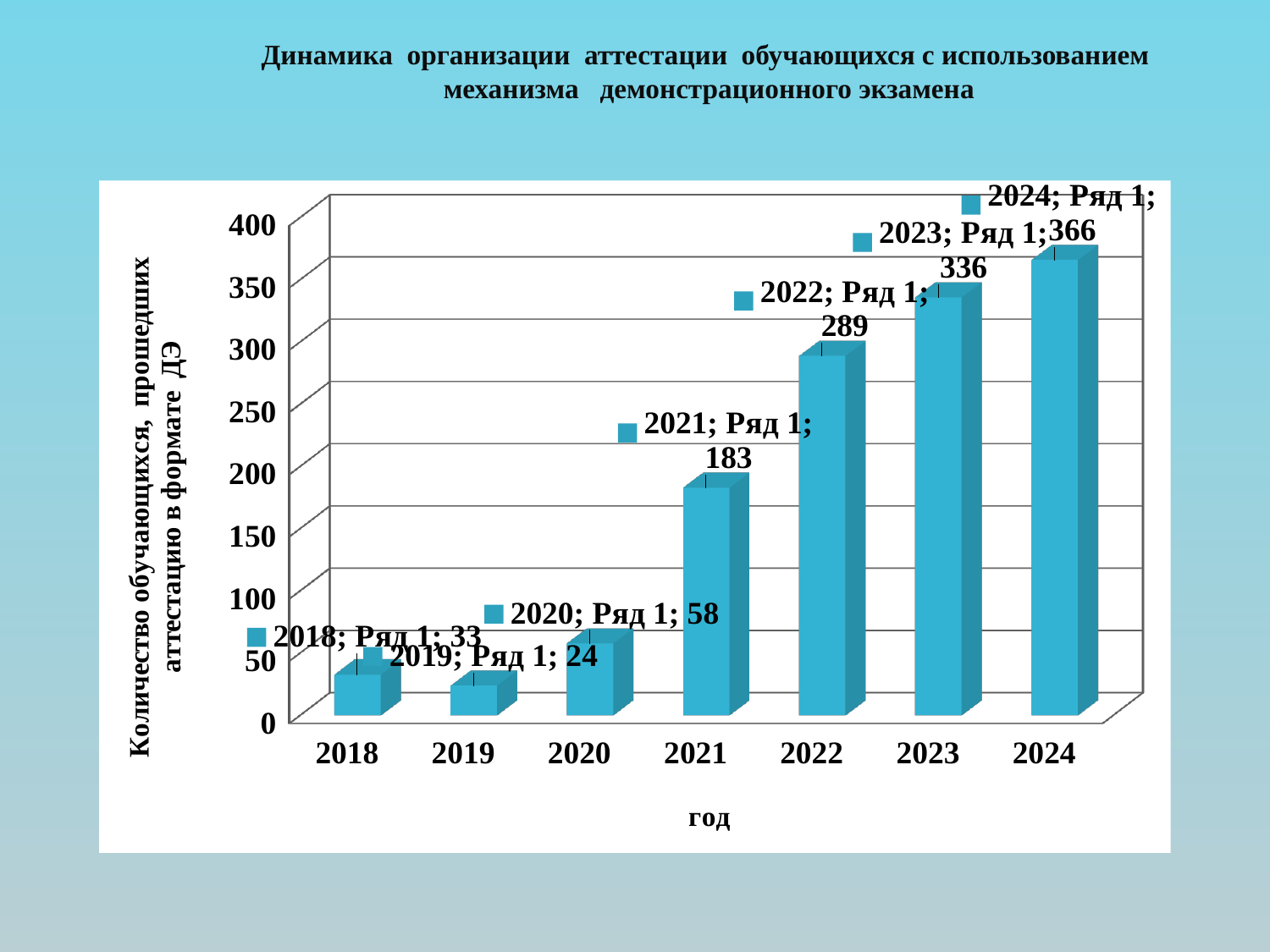
Is the value for 2022 greater or less than 250? greater What is the difference between the values for 2023 and 2022? 47 What kind of chart is shown on the slide? bar chart What is the label of the x axis? год What is the value for 2021? 183 How many years are shown on the x axis? 7 Which is larger, the value for 2018 or the value for 2019? 2018 What is the value for 2024? 366 Which year has the highest value? 2024 What is the value for 2019? 24 Which year has the lowest value? 2019 What is the difference between the values for 2020 and 2018? 25